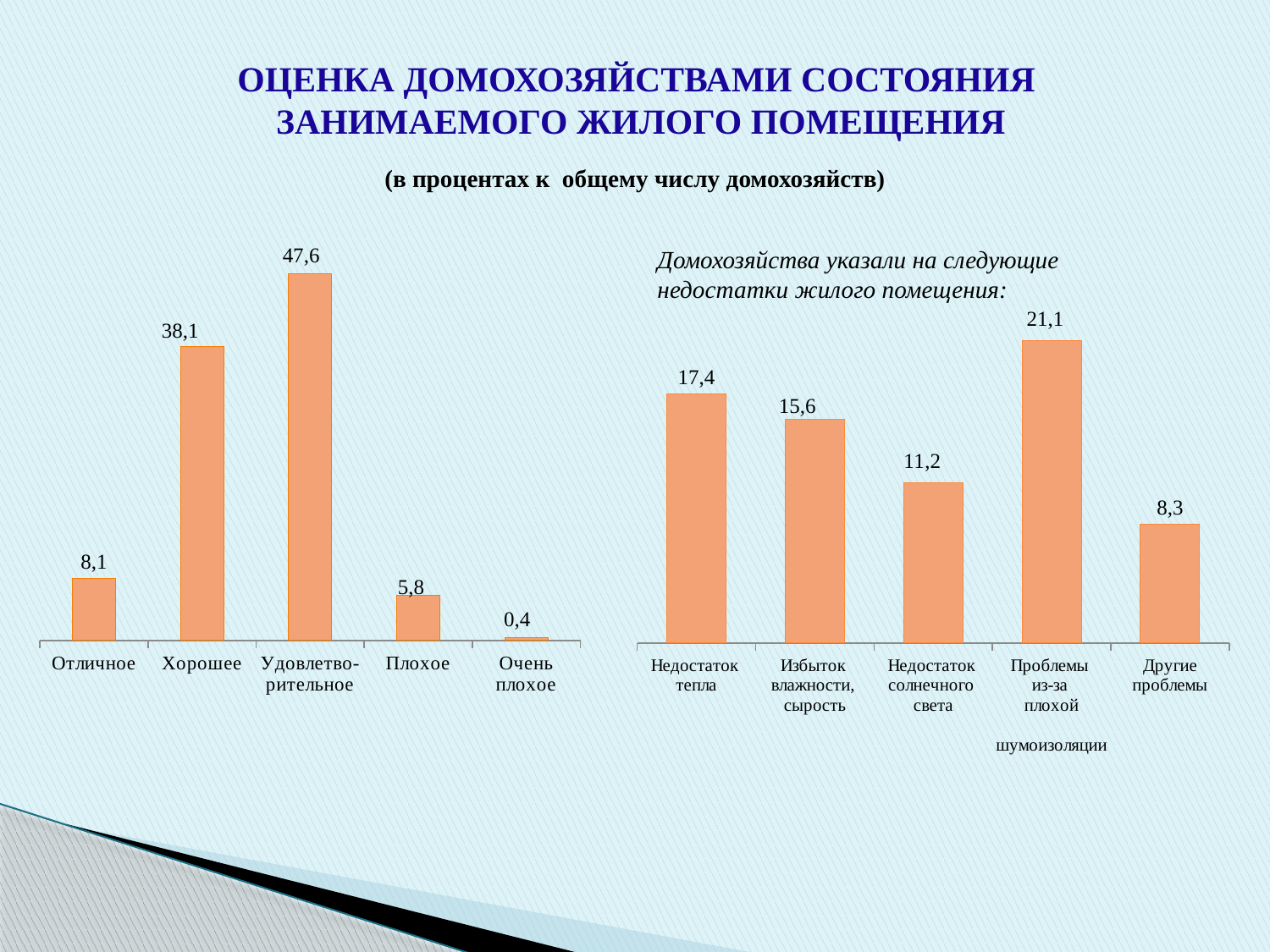
In the right chart, which is larger: the value for "Недостаток тепла" or for "Избыток влажности, сырость"? Недостаток тепла In the right chart, which category has the lowest value? Другие проблемы In the right chart, what is the value for "Недостаток солнечного света"? 11,2 In the left chart, which category has the lowest value? Очень плохое In the right chart, what is the difference between the values for "Проблемы из-за плохой шумоизоляции" and "Другие проблемы"? 12,8 In the left chart, what is the value for "Удовлетворительное"? 47,6 In the left chart, which category has the highest value? Удовлетворительное In the left chart, what is the value for "Очень плохое"? 0,4 In the right chart, which category has the highest value? Проблемы из-за плохой шумоизоляции What type of chart is the right chart? Bar chart In the left chart, how many categories are shown? 5 In the left chart, what is the difference between the values for "Хорошее" and "Отличное"? 30,0